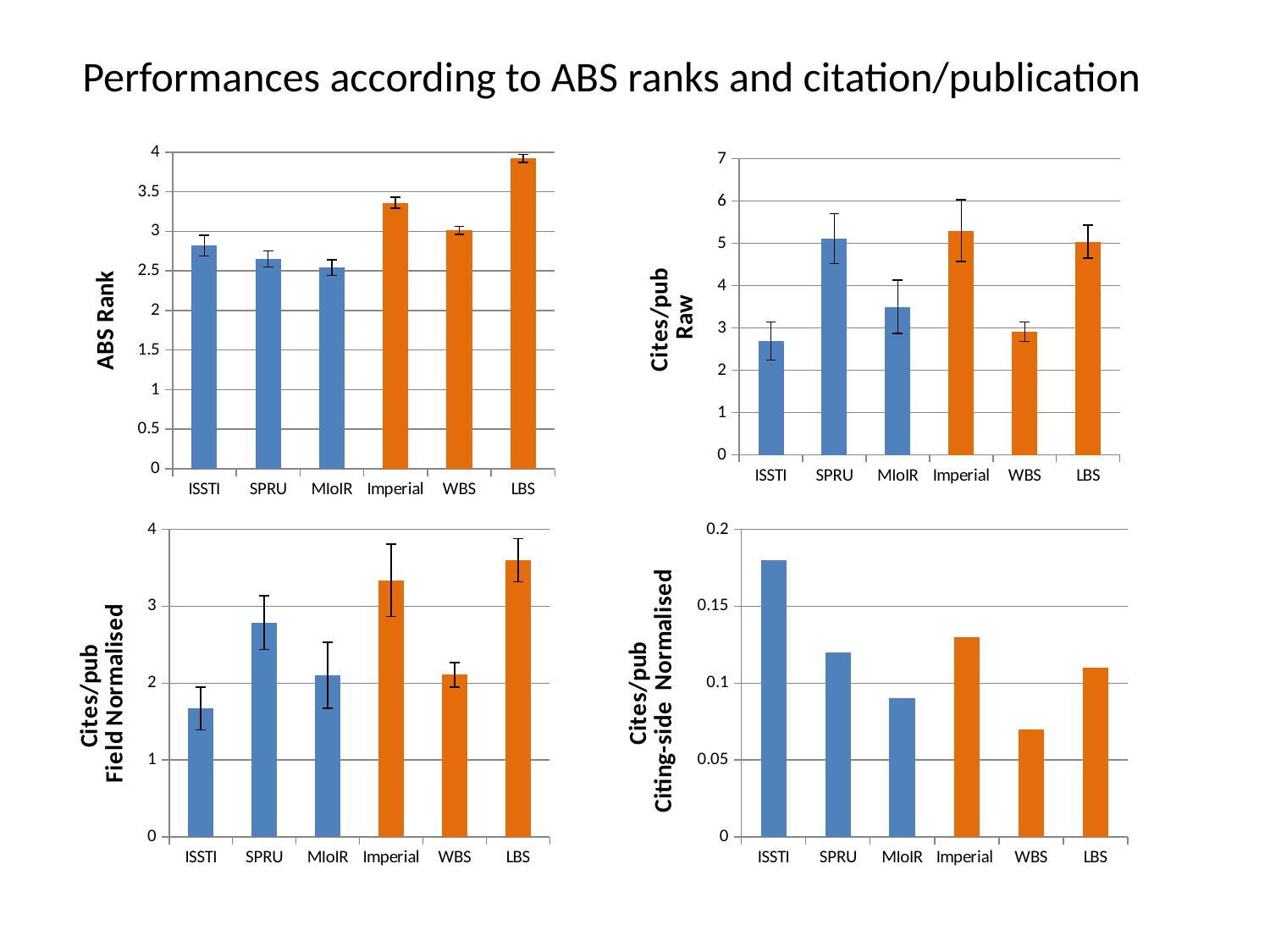
In the ABS Rank chart (top left), is the value for Imperial greater or less than 3? greater In the Cites/pub Raw chart (top right), which is larger, the value for SPRU or the value for WBS? SPRU In the Cites/pub Raw chart (top right), is the value for MIoIR greater or less than 4? less In the Cites/pub Citing-side Normalised chart (bottom right), is the value for ISSTI greater or less than 0.15? greater In the ABS Rank chart (top left), which is larger, the value for ISSTI or the value for LBS? LBS How many categories are shown on the x axis of the Cites/pub Raw chart (top right)? 6 In the Cites/pub Citing-side Normalised chart (bottom right), which category has the lowest value? WBS In the Cites/pub Field Normalised chart (bottom left), which category has the lowest value? ISSTI In the ABS Rank chart (top left), which category has the highest value? LBS In the Cites/pub Citing-side Normalised chart (bottom right), which category has the highest value? ISSTI What kind of chart is the Cites/pub Field Normalised chart (bottom left)? bar chart